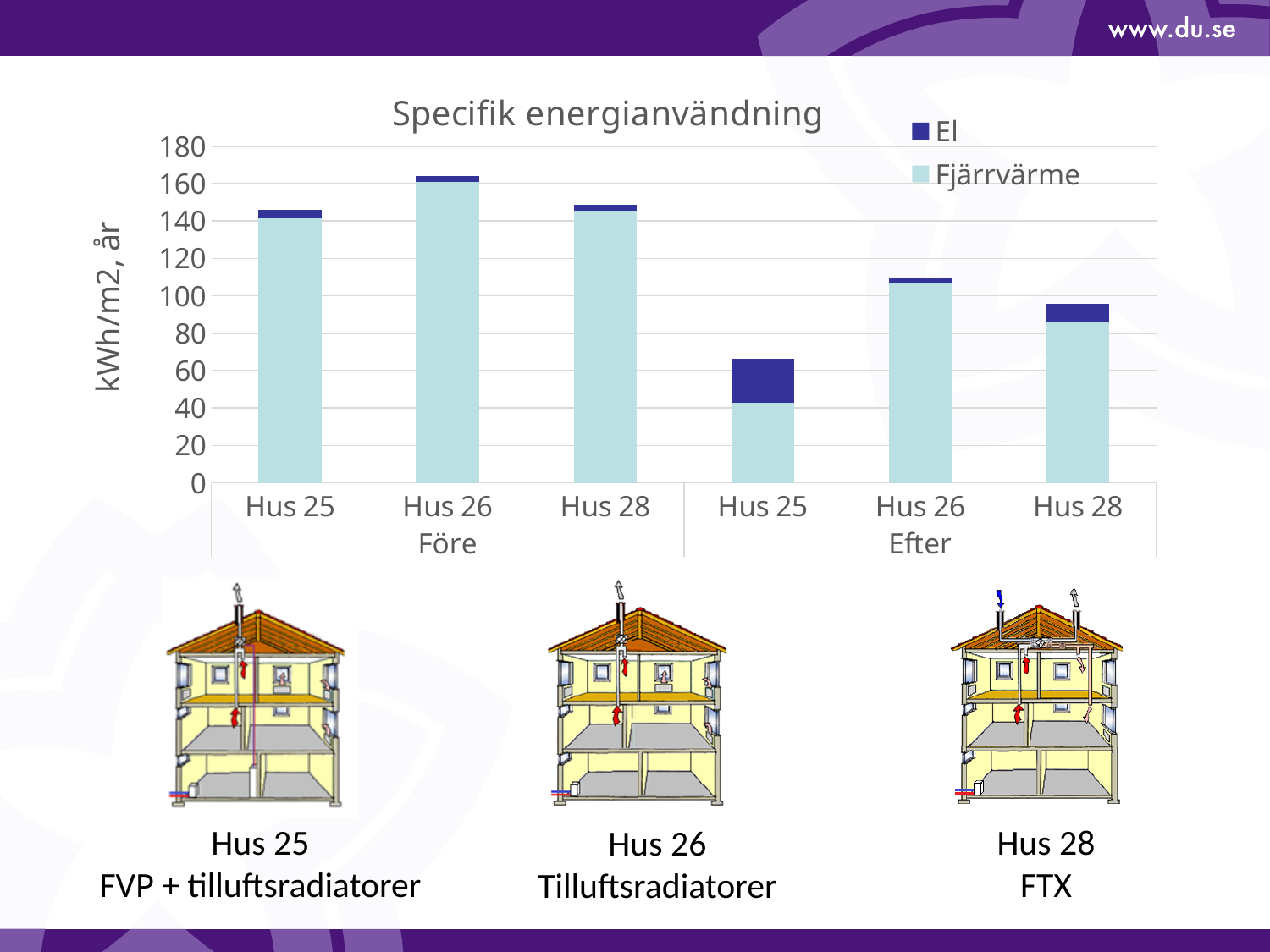
Do the total values for each house fall or rise from the Före group to the Efter group? Fall What are the two series named in the legend? El and Fjärrvärme Which bar has the lowest total value? Hus 25 (Efter) How many bars are plotted in the chart? 6 Is the total value for Hus 26 in the Efter group greater or less than 100? greater How many series does the legend list? 2 Is the total value for Hus 26 in the Före group greater or less than 160? greater Is the total value for Hus 25 in the Efter group greater or less than 80? less Which bar has the highest total value? Hus 26 (Före) Which is larger, the total for Hus 28 in the Före group or the total for Hus 28 in the Efter group? Hus 28 in the Före group What kind of chart is shown on the slide? Stacked bar chart What is the title of the chart? Specifik energianvändning